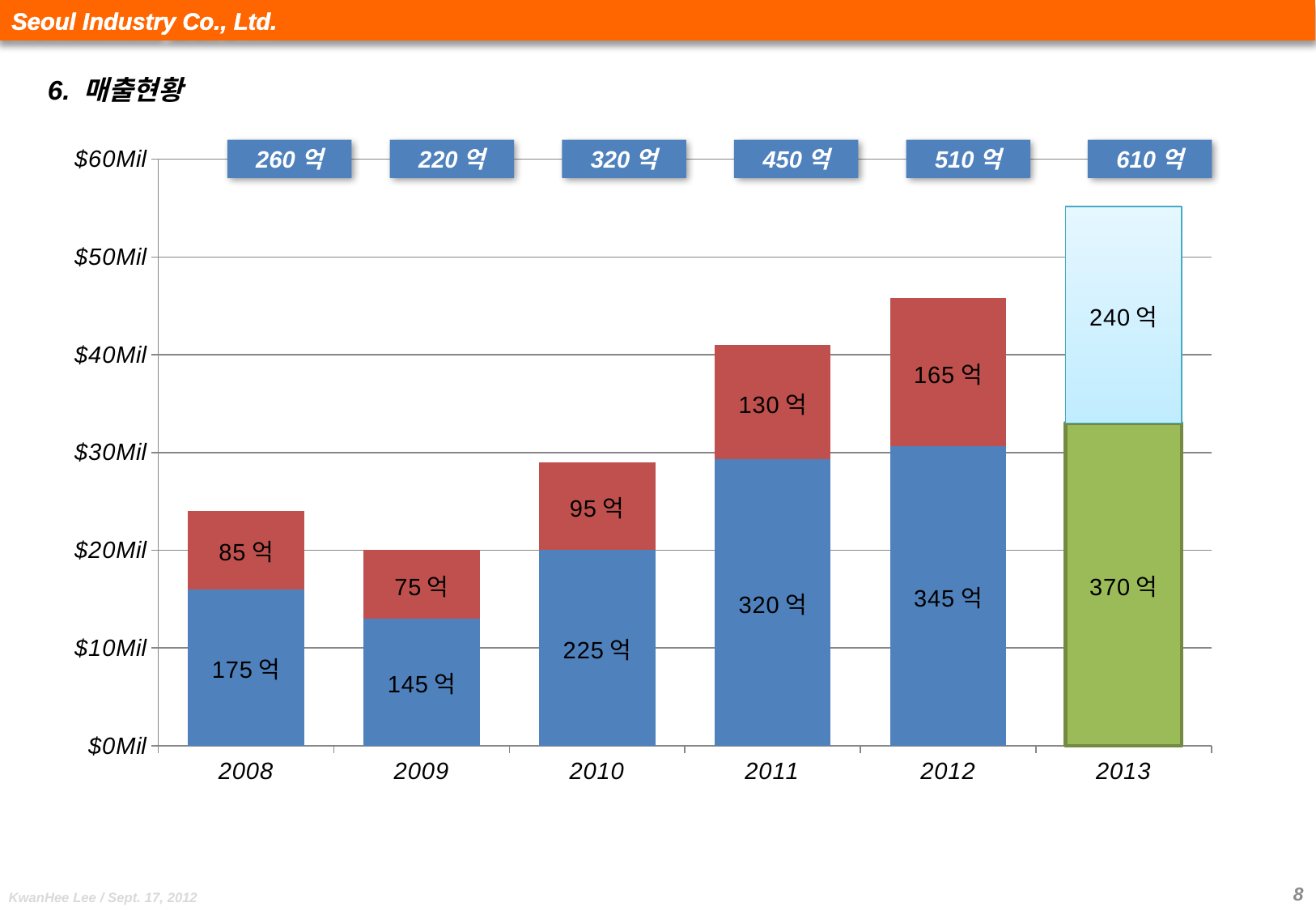
How many years are shown on the x axis of the chart? 6 What is the value of the top segment of the bar for 2012? 165 억 Do the totals generally rise or fall from 2009 to 2013? rise What is the total of the stacked bar for 2013? 610 억 Which year has the lowest total? 2009 What is the difference between the bottom segment values for 2012 and 2011? 25 억 Is the total bar for 2012 greater or less than $40Mil on the axis? greater What total is shown in the box above the bar for 2011? 450 억 What kind of chart is shown on the slide? Stacked bar chart Which is larger, the top segment for 2008 or the top segment for 2009? 2008 What is the value of the bottom segment of the bar for 2010? 225 억 Which year has the highest total? 2013